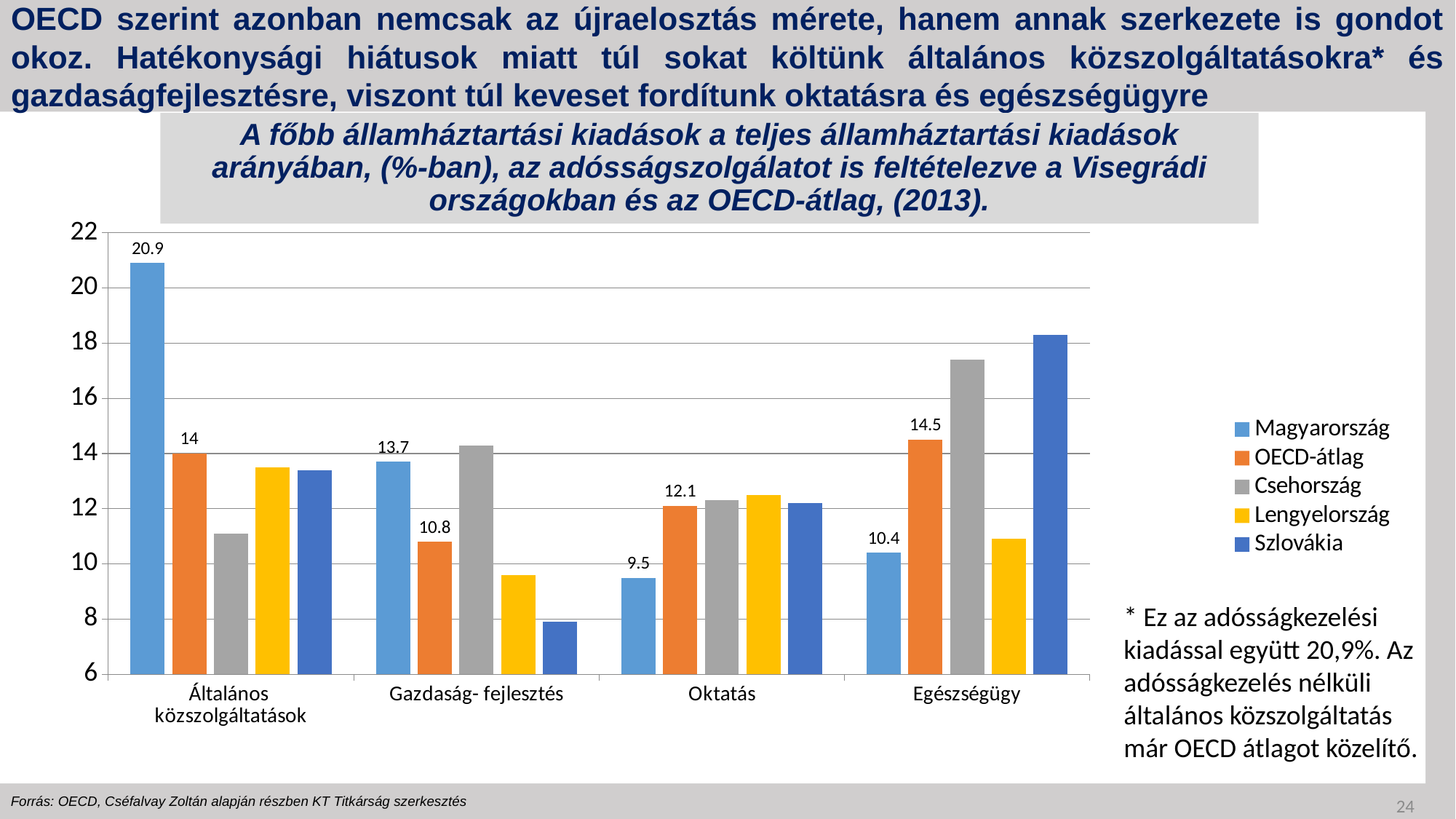
What is the difference between the Magyarország and OECD-átlag values in the Általános közszolgáltatások category? 6.9 What is the value for OECD-átlag in the Egészségügy category? 14.5 In which category does Magyarország have its highest value? Általános közszolgáltatások What is the value for Magyarország in the Általános közszolgáltatások category? 20.9 How many series does the legend list? 5 What kind of chart is shown on the slide? Bar chart What is the value for Magyarország in the Oktatás category? 9.5 Is the value for Szlovákia in the Egészségügy category greater or less than 18? greater What is the difference between the OECD-átlag and Magyarország values in the Egészségügy category? 4.1 In the Gazdaság- fejlesztés category, which is larger: the Magyarország value or the OECD-átlag value? Magyarország Which series has the lowest value in the Oktatás category? Magyarország